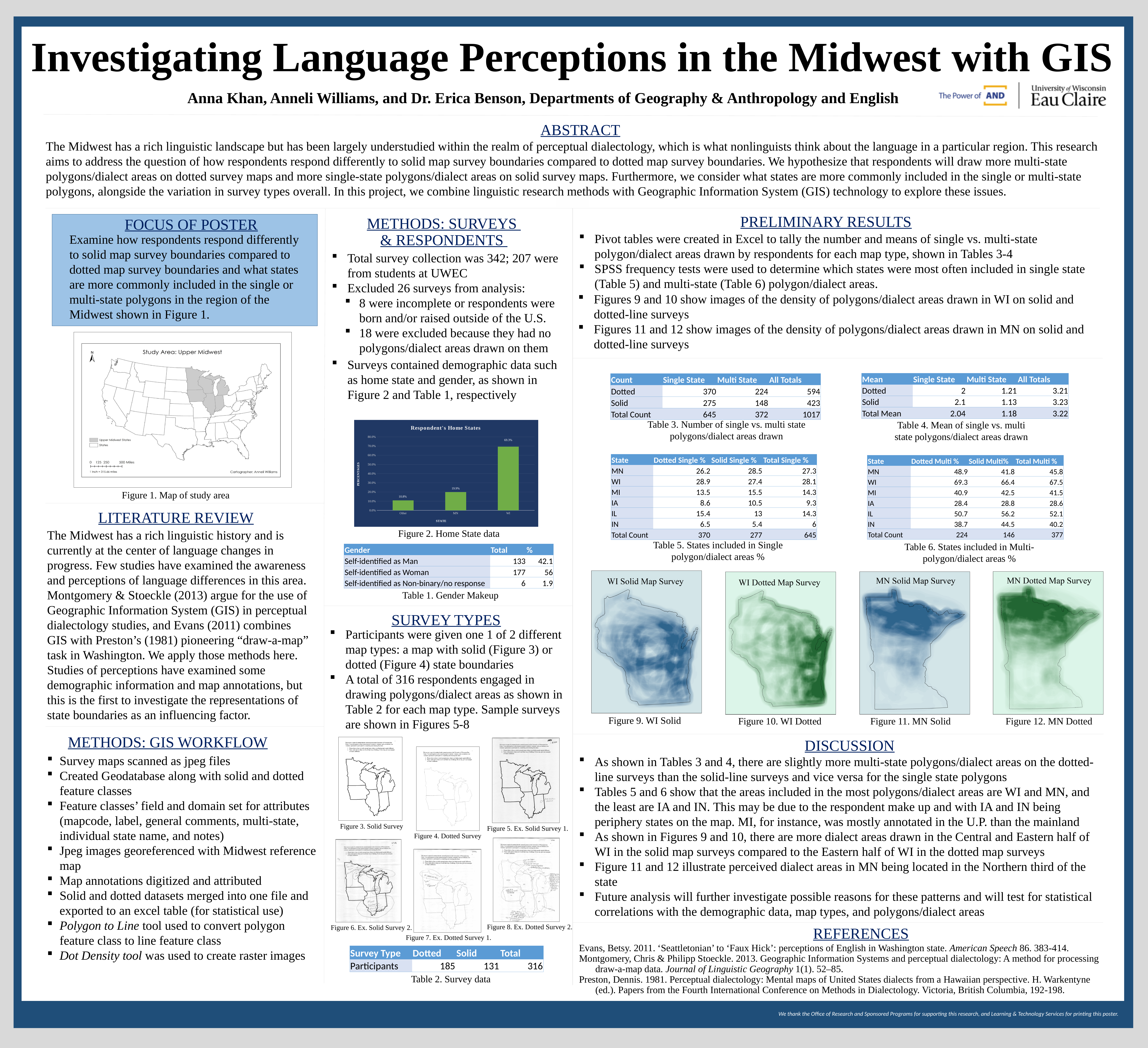
What kind of chart is Figure 2, "Respondent's Home States"? bar chart In the "Respondent's Home States" chart, which is larger, the value for MN or the value for Other? MN In the "Respondent's Home States" chart, is the value for WI greater or less than 60.0%? greater In the "Respondent's Home States" chart, what is the value for Other? 10.8% In the "Respondent's Home States" chart, which category has the lowest value? Other What is the title of the bar chart shown in Figure 2? Respondent's Home States Do the values in the "Respondent's Home States" chart rise or fall from left to right along the x axis? rise In the "Respondent's Home States" chart, what is the difference between the values for WI and MN? 49.4% In the "Respondent's Home States" chart, what is the value for MN? 19.9% How many categories are shown on the x axis of the "Respondent's Home States" chart? 3 In the "Respondent's Home States" chart, what is the value for WI? 69.3% In the "Respondent's Home States" chart, which state category has the highest value? WI